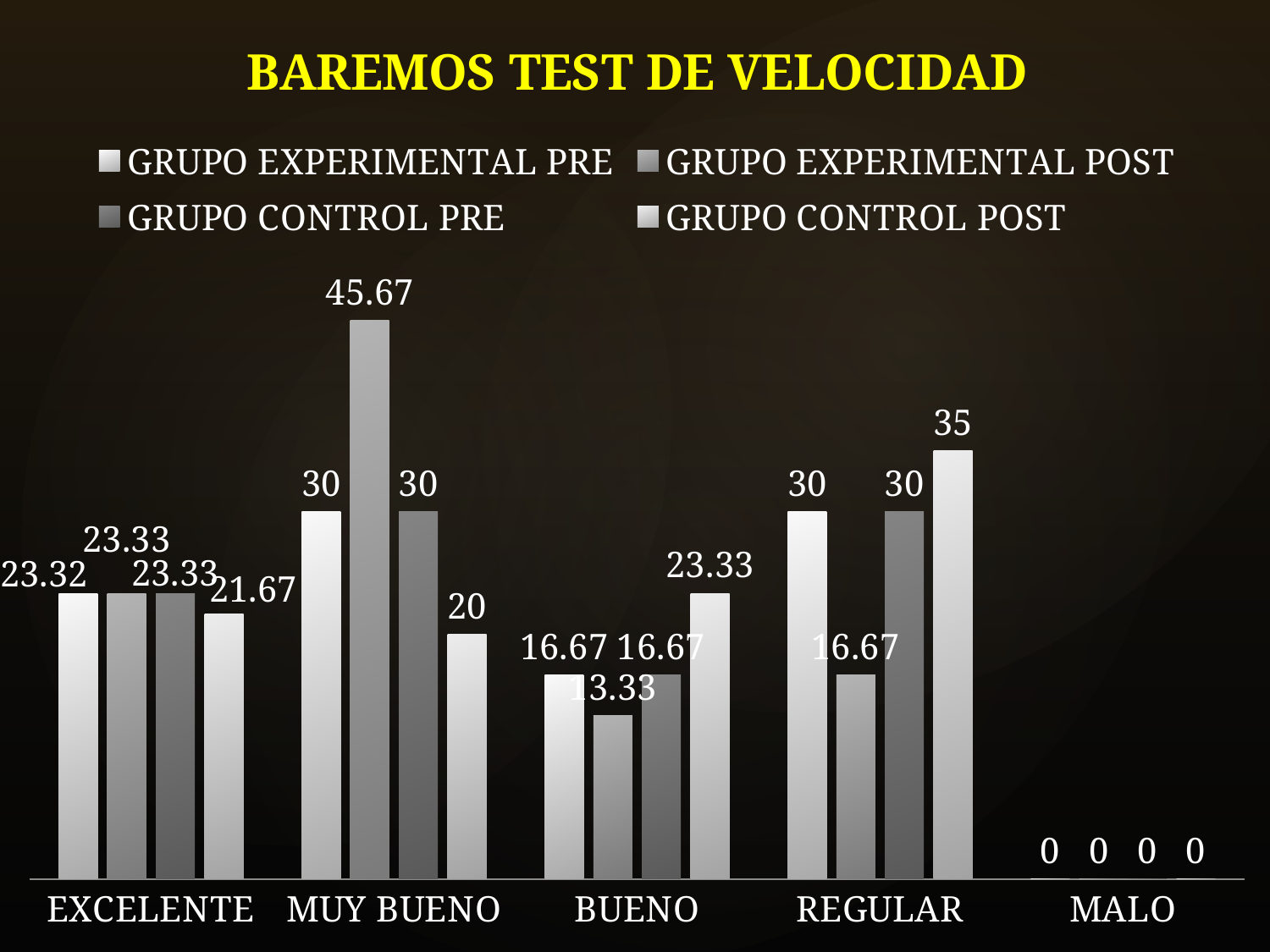
What type of chart is shown on the slide? bar chart Which is larger in the REGULAR category: GRUPO EXPERIMENTAL POST or GRUPO CONTROL POST? GRUPO CONTROL POST What is the value for GRUPO EXPERIMENTAL POST in the MUY BUENO category? 45.67 What is the difference between GRUPO EXPERIMENTAL POST and GRUPO CONTROL POST in the MUY BUENO category? 25.67 Which category has the highest value for GRUPO EXPERIMENTAL POST? MUY BUENO What is the title of the chart? BAREMOS TEST DE VELOCIDAD What is the value for GRUPO EXPERIMENTAL POST in the BUENO category? 13.33 How many categories are shown on the x axis? 5 What is the value for GRUPO EXPERIMENTAL PRE in the EXCELENTE category? 23.32 Which category has the lowest values for all four series? MALO How many series does the legend list? 4 What is the value for GRUPO CONTROL POST in the REGULAR category? 35